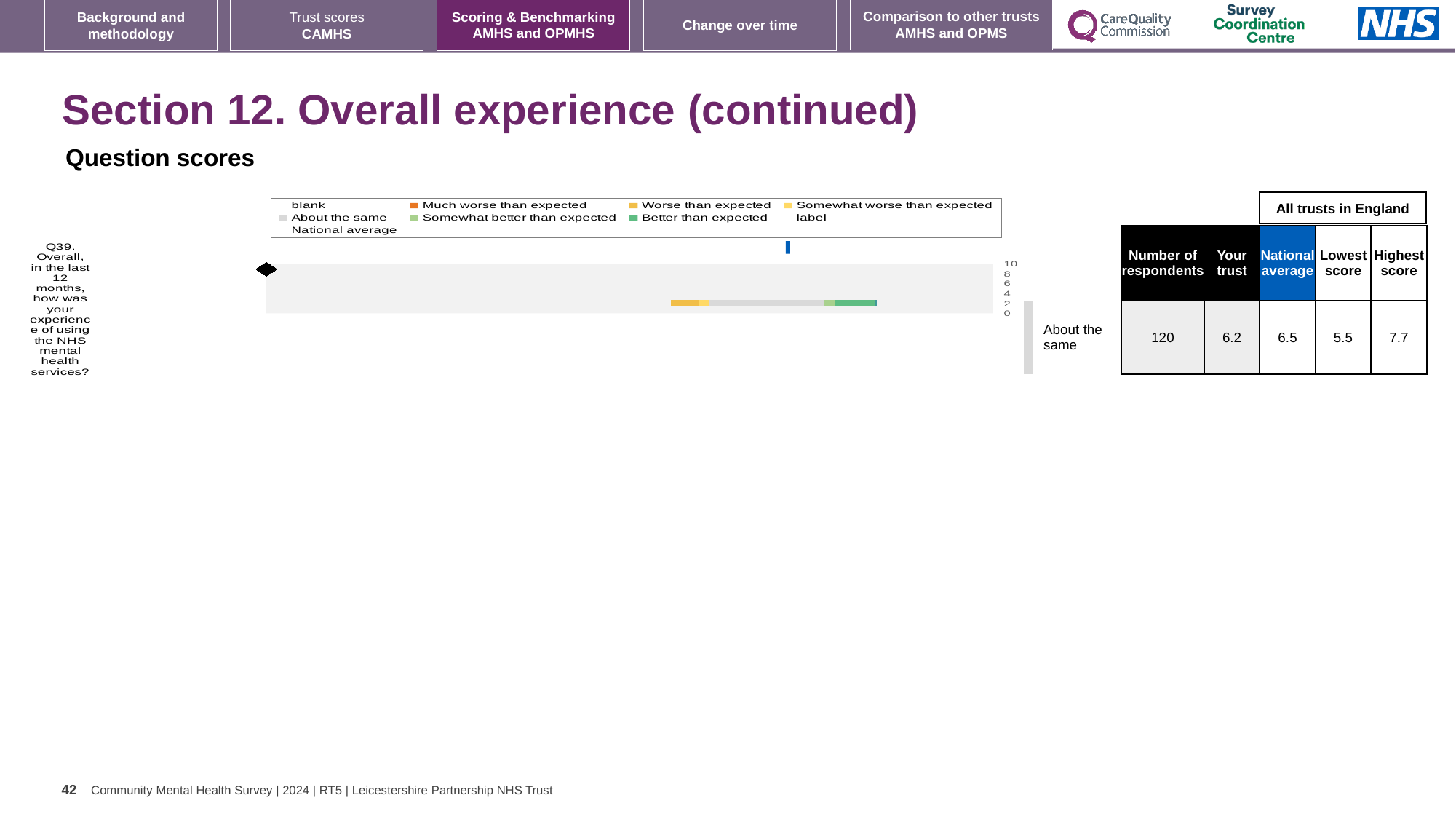
What kind of chart is used to show the Q39 score? bar chart What is the 'Your trust' score for Q39 (Overall, in the last 12 months, how was your experience of using the NHS mental health services?)? 6.2 What is the national average score shown for Q39? 6.5 How many questions are plotted on the chart? 1 What is the maximum value shown on the chart's score axis? 10 What is the lowest score among all trusts in England for Q39? 5.5 What is the highest score among all trusts in England for Q39? 7.7 How many respondents answered Q39? 120 Which benchmark category is the trust's Q39 score placed in? About the same Is the 'Your trust' score for Q39 higher or lower than the national average? lower What is the difference between the highest score and the lowest score for Q39? 2.2 What is the difference between the national average and the 'Your trust' score for Q39? 0.3